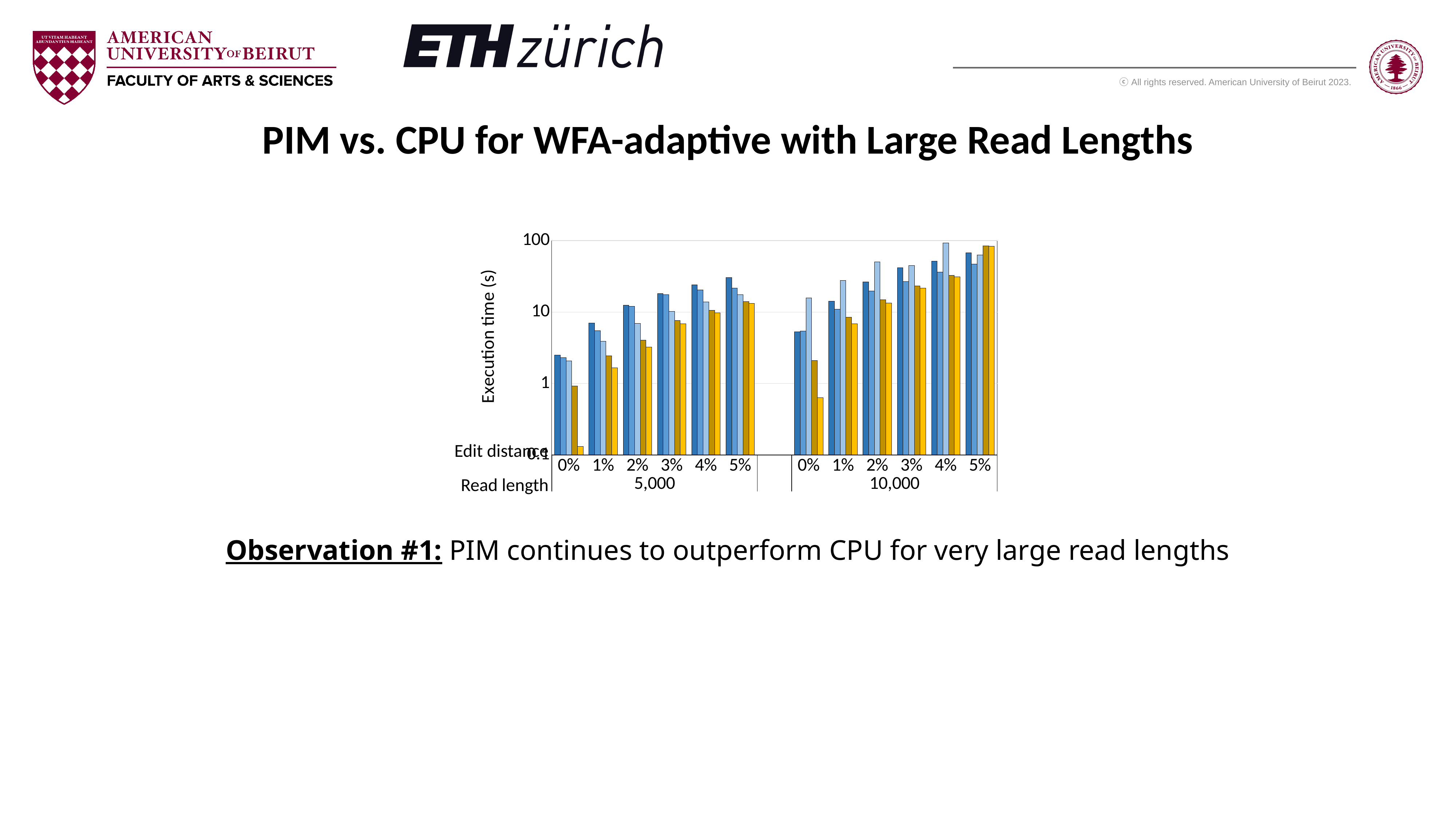
For read length 10,000 at 5% edit distance, are all the bars greater or less than 10? greater What is the highest tick value shown on the y-axis? 100 How many edit distance categories are shown for each read length? 6 For read length 10,000, is the shortest bar at 0% edit distance greater or less than 1? less For read length 5,000, is the tallest bar at 1% edit distance greater or less than 10? less At 5% edit distance, which read length has the taller tallest bar, 5,000 or 10,000? 10,000 For read length 5,000, at which edit distance does the tallest bar occur? 5% For read length 5,000, does the execution time of the dark blue bars rise or fall as edit distance increases from 0% to 5%? rise What kind of chart is shown on the slide? Bar chart How many read length groups are shown on the x-axis? 2 What is the label of the y-axis of the chart? Execution time (s)